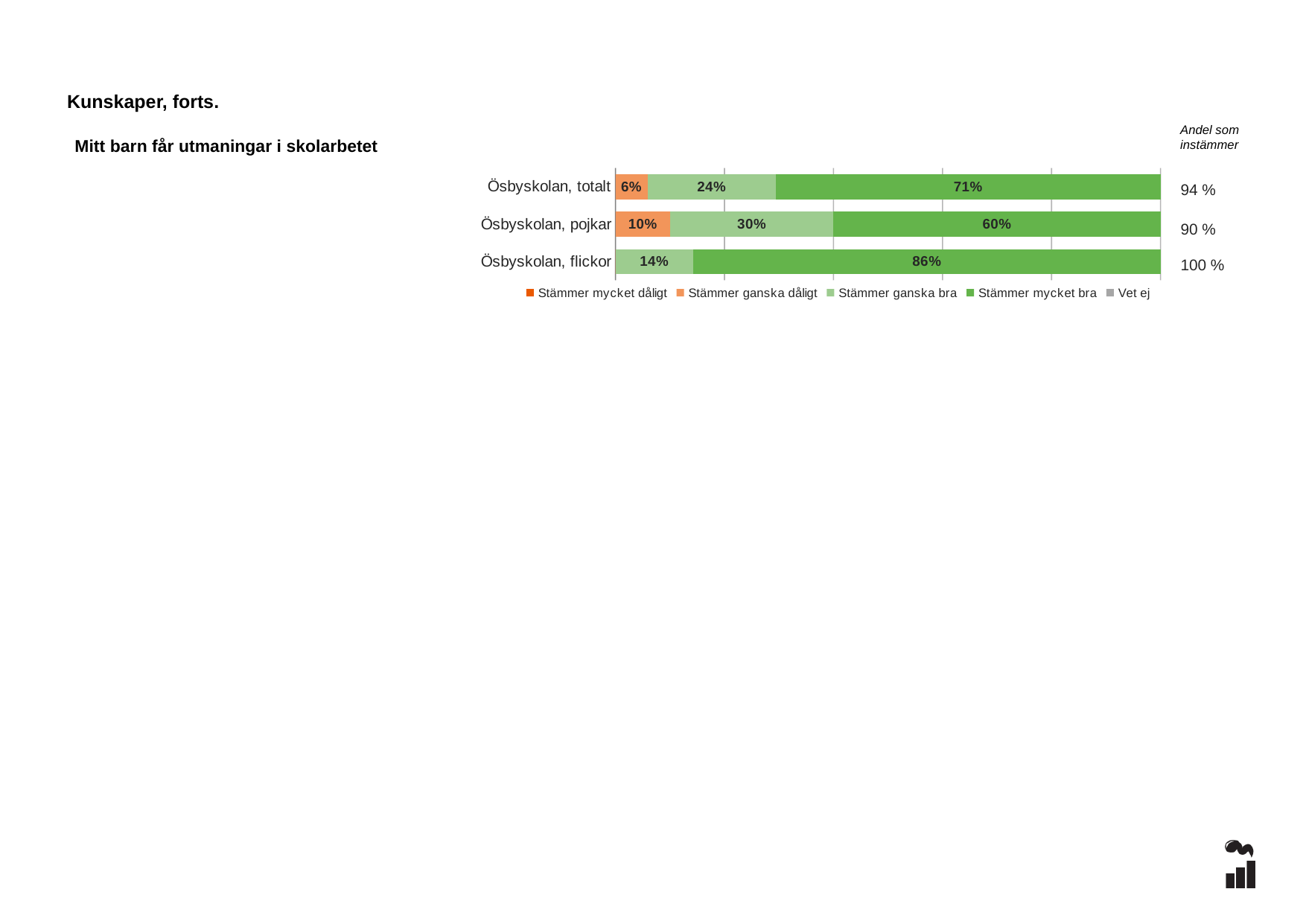
What is the 'Andel som instämmer' value shown for 'Ösbyskolan, pojkar'? 90 % What percentage of 'Ösbyskolan, pojkar' answered 'Stämmer ganska dåligt'? 10% Which category has the lowest 'Stämmer mycket bra' share? Ösbyskolan, pojkar What percentage of 'Ösbyskolan, totalt' answered 'Stämmer mycket bra'? 71% What kind of chart is shown on the slide? Stacked bar chart How many categories are shown in the chart? 3 What is the difference in the 'Stämmer mycket bra' share between 'Ösbyskolan, flickor' and 'Ösbyskolan, pojkar'? 26% Which has a larger 'Stämmer ganska bra' share, 'Ösbyskolan, totalt' or 'Ösbyskolan, pojkar'? Ösbyskolan, pojkar How many series does the legend list? 5 Which category has the highest 'Stämmer mycket bra' share? Ösbyskolan, flickor What is the statement shown as the chart's title? Mitt barn får utmaningar i skolarbetet What percentage of 'Ösbyskolan, flickor' answered 'Stämmer ganska bra'? 14%